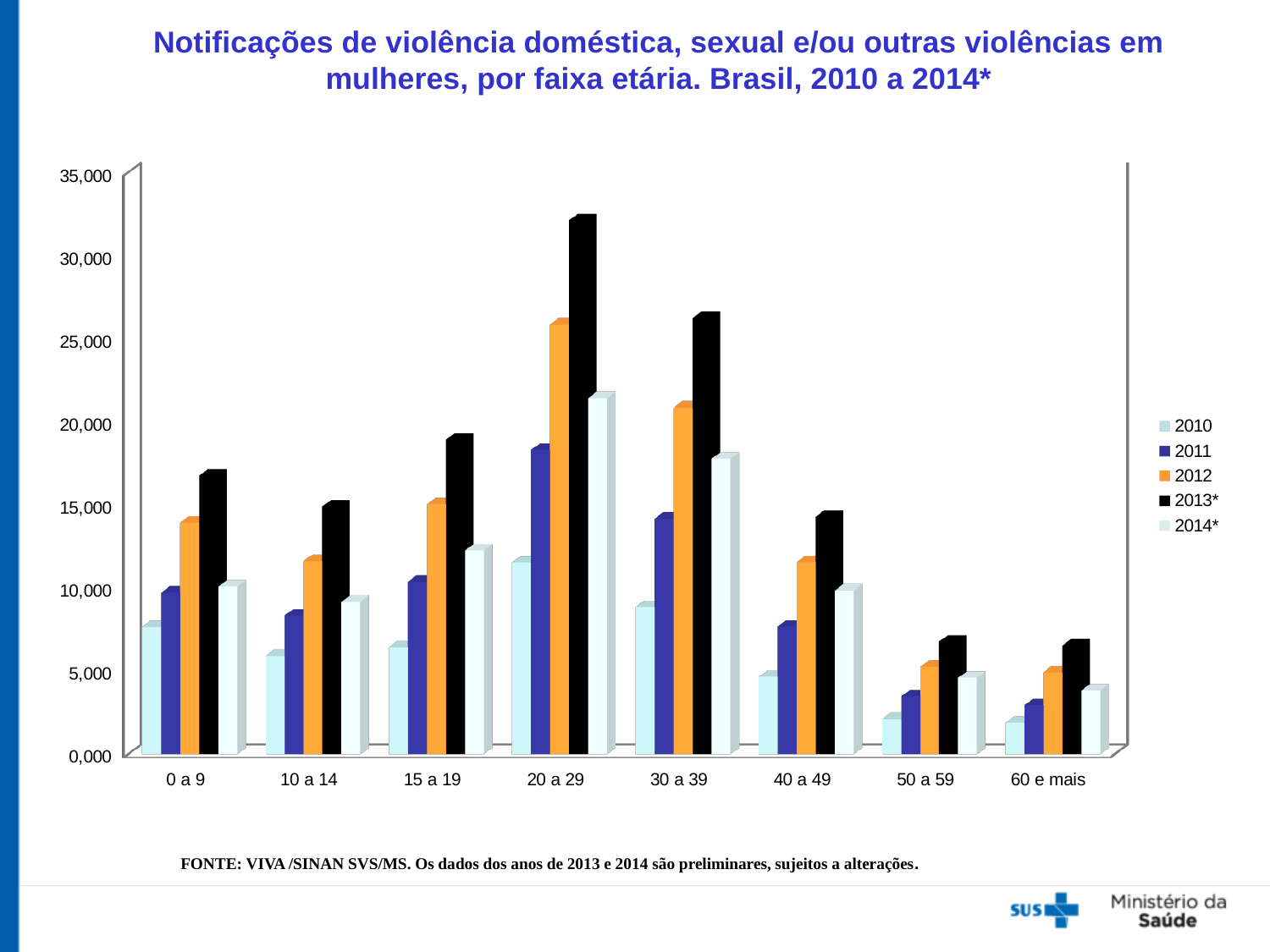
How many series does the legend list? 5 How many age groups (categories) are shown on the x axis? 8 Within the 20 a 29 age group, do the values rise or fall from 2010 to 2013*? rise Is the value for 2013* in the 20 a 29 age group greater or less than 30,000? greater Is the value for 2014* in the 20 a 29 age group greater or less than 20,000? greater Which age group has the highest bar for 2012? 20 a 29 In the 0 a 9 age group, which is larger: the 2012 bar or the 2013* bar? 2013* Which colour represents the 2013* series in the legend? black What kind of chart is shown on the slide? bar chart Is the value for 2011 in the 50 a 59 age group greater or less than 5,000? less Which age group has the highest bar for 2013*? 20 a 29